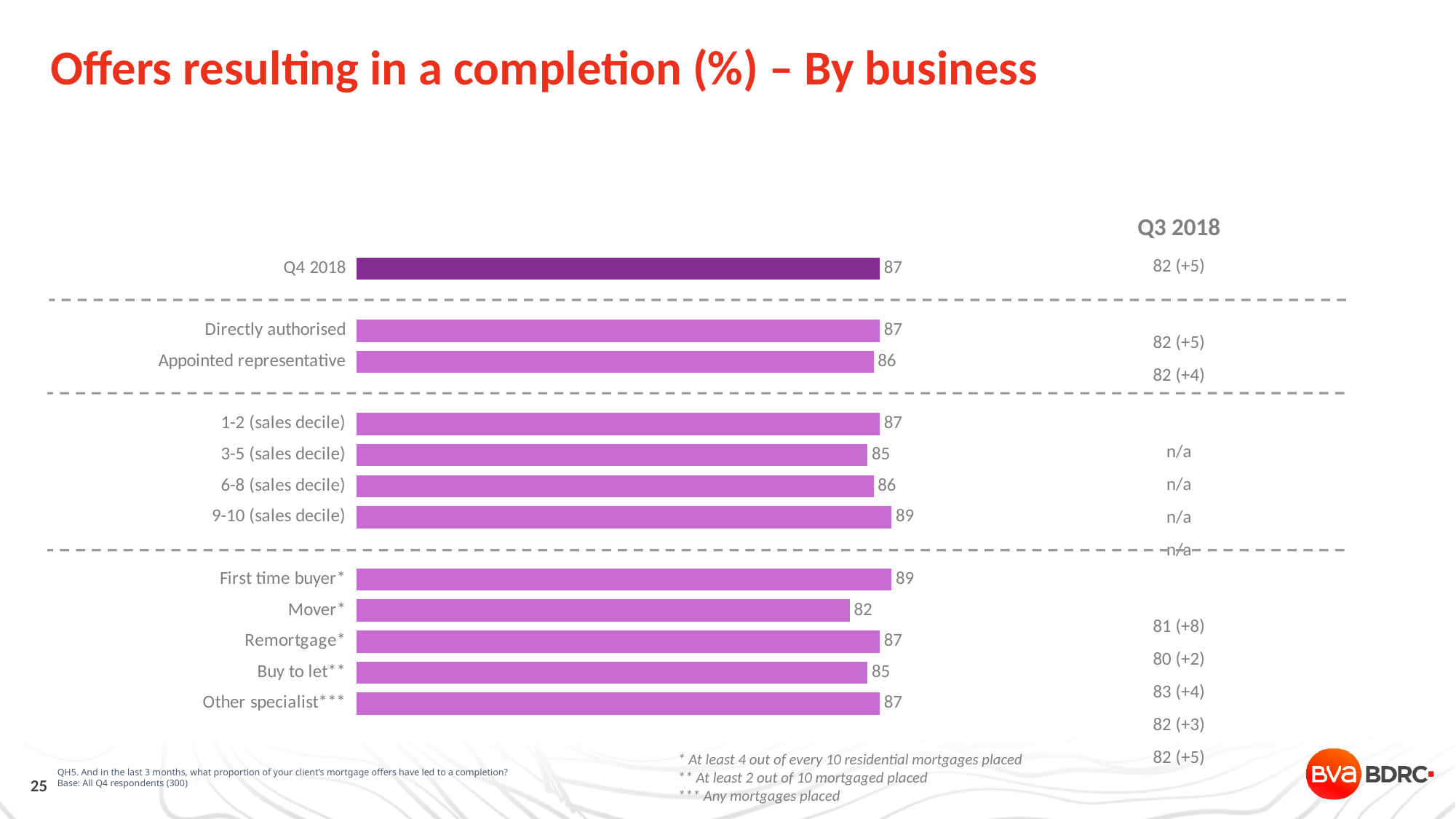
Which category has the lowest value in the chart? Mover What kind of chart is shown on the slide? Bar chart What is the value for the Q4 2018 bar at the top of the chart? 87 How many bars are plotted in the chart? 12 What is the value for Appointed representative? 86 What is the difference between the values for First time buyer and Mover? 7 Which bar is drawn in a darker purple than the others? Q4 2018 Among the sales decile categories, which has the highest value? 9-10 (sales decile) What is the value for Mover? 82 What is the value for 9-10 (sales decile)? 89 What is the difference between the values for Directly authorised and Appointed representative? 1 Which is larger, the value for 9-10 (sales decile) or 3-5 (sales decile)? 9-10 (sales decile)